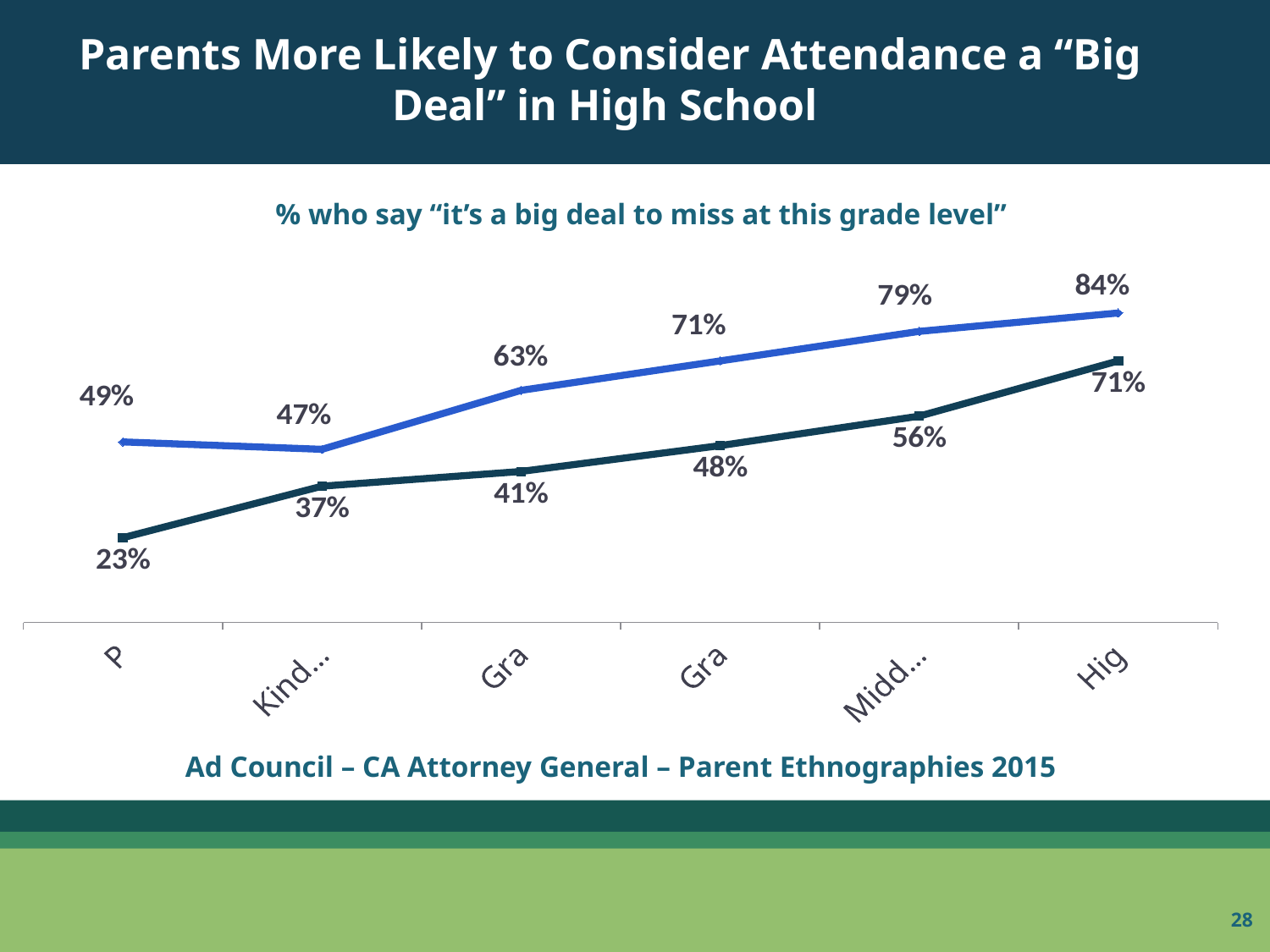
What is the value of the dark teal line at the rightmost point? 71% How many data points does each line on the chart have? 6 What kind of chart is shown on the slide? Line chart Does the dark teal line rise or fall from left to right across the chart? Rise What is the highest value shown on the blue line? 84% What is the value of the blue line at the leftmost point? 49% What is the value of the blue line at the rightmost point? 84% What is the source cited below the chart? Ad Council – CA Attorney General – Parent Ethnographies 2015 At the rightmost point, what is the difference between the blue line value and the dark teal line value? 13 percentage points What is the lowest value shown on the dark teal line? 23% How many lines are plotted on the chart? 2 What is the value of the dark teal line at the leftmost point? 23%